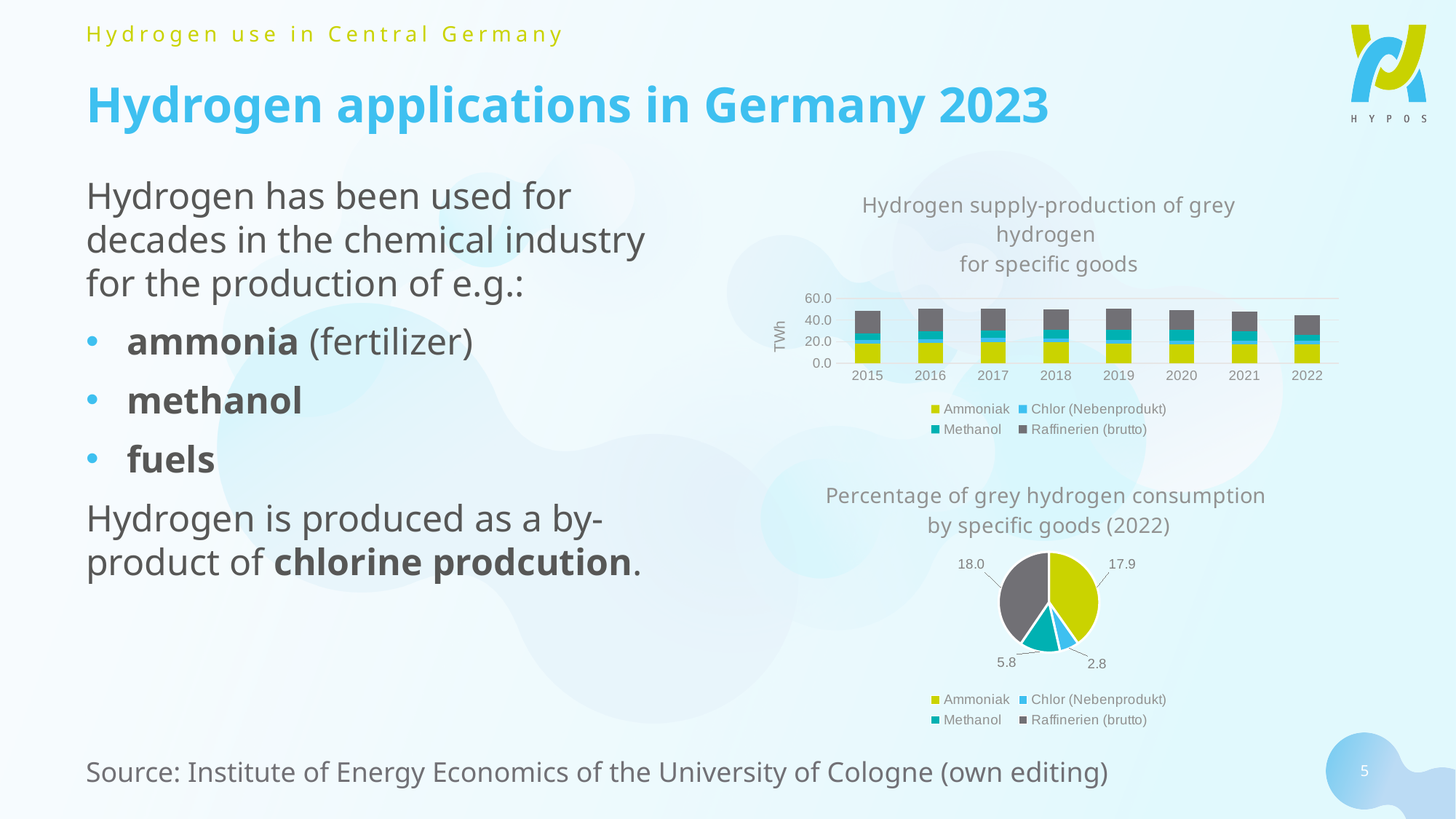
In the bottom pie chart, what is the value for Chlor (Nebenprodukt)? 2.8 In the bottom pie chart, what is the value for Ammoniak? 17.9 In the top bar chart, how many years are shown on the x axis? 8 What kind of chart is the bottom chart titled 'Percentage of grey hydrogen consumption by specific goods (2022)'? pie chart In the bottom pie chart, what is the difference between the values for Raffinerien (brutto) and Chlor (Nebenprodukt)? 15.2 In the top bar chart, is the total height of the stacked bar for 2015 greater or less than 40? greater In the top bar chart, what unit is shown on the y axis? TWh In the bottom pie chart, which category has the smallest slice? Chlor (Nebenprodukt) In the top bar chart, how many series does the legend list? 4 In the bottom pie chart, what is the value for Methanol? 5.8 What kind of chart is the top chart titled 'Hydrogen supply-production of grey hydrogen for specific goods'? bar chart In the top bar chart, is the total height of the stacked bar for 2022 greater or less than 60? less